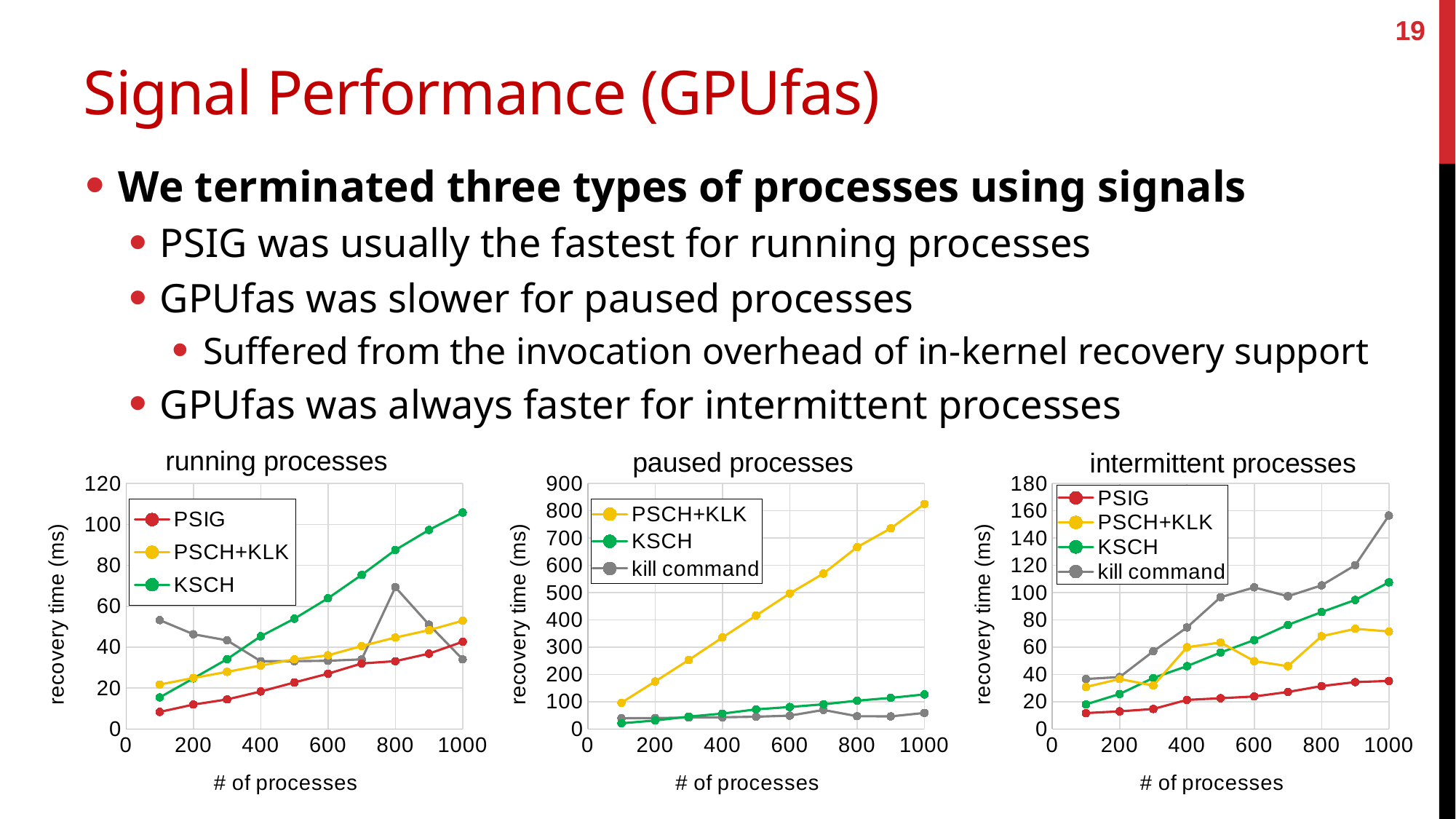
In the "intermittent processes" chart, is the value for kill command at 1000 processes greater or less than 140? greater How many series does the legend of the "paused processes" chart list? 3 In the "running processes" chart, which series has the lowest recovery time at 100 processes? PSIG How many data points does the PSIG series have in the "running processes" chart? 10 In the "paused processes" chart, does the PSCH+KLK series rise or fall as the number of processes increases? rise In the "running processes" chart, is the value for KSCH at 1000 processes greater or less than 100? greater In the "intermittent processes" chart, which is larger at 1000 processes, KSCH or PSCH+KLK? KSCH What kind of chart is the "running processes" chart? line chart In the "intermittent processes" chart, is the value for PSIG at 1000 processes greater or less than 40? less In the "paused processes" chart, which series has the highest recovery time at 1000 processes? PSCH+KLK How many series does the legend of the "intermittent processes" chart list? 4